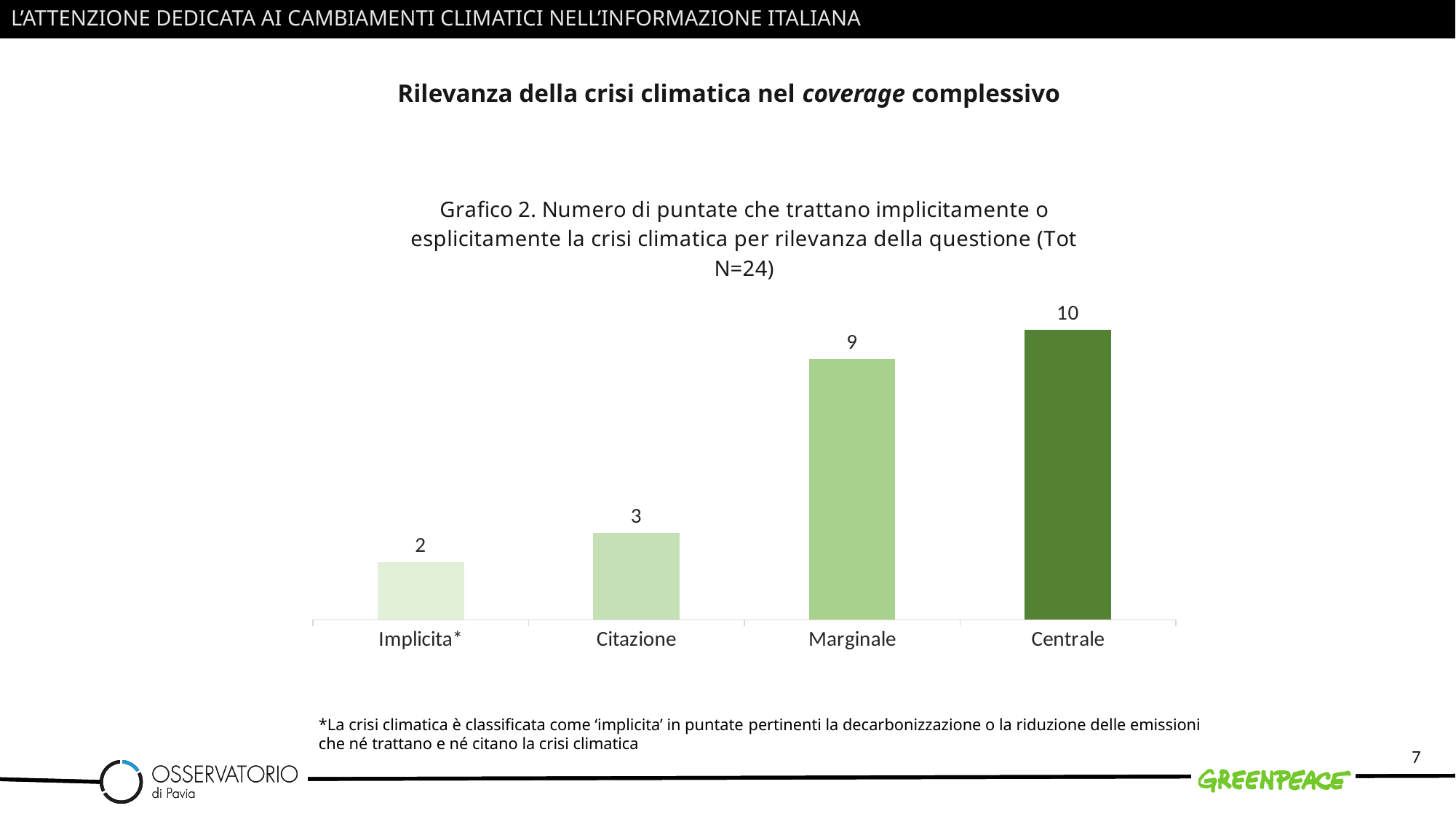
What kind of chart is shown on the slide? Bar chart Which category has the highest value? Centrale What is the value for Citazione? 3 What is the value for Marginale? 9 Do the values rise or fall from left to right along the x axis? Rise What is the difference between the values for Marginale and Implicita*? 7 What is the difference between the values for Centrale and Citazione? 7 How many categories are shown on the x axis? 4 Which is larger, the value for Marginale or the value for Citazione? Marginale What is the value for Centrale? 10 Which category has the lowest value? Implicita* What is the value for Implicita*? 2